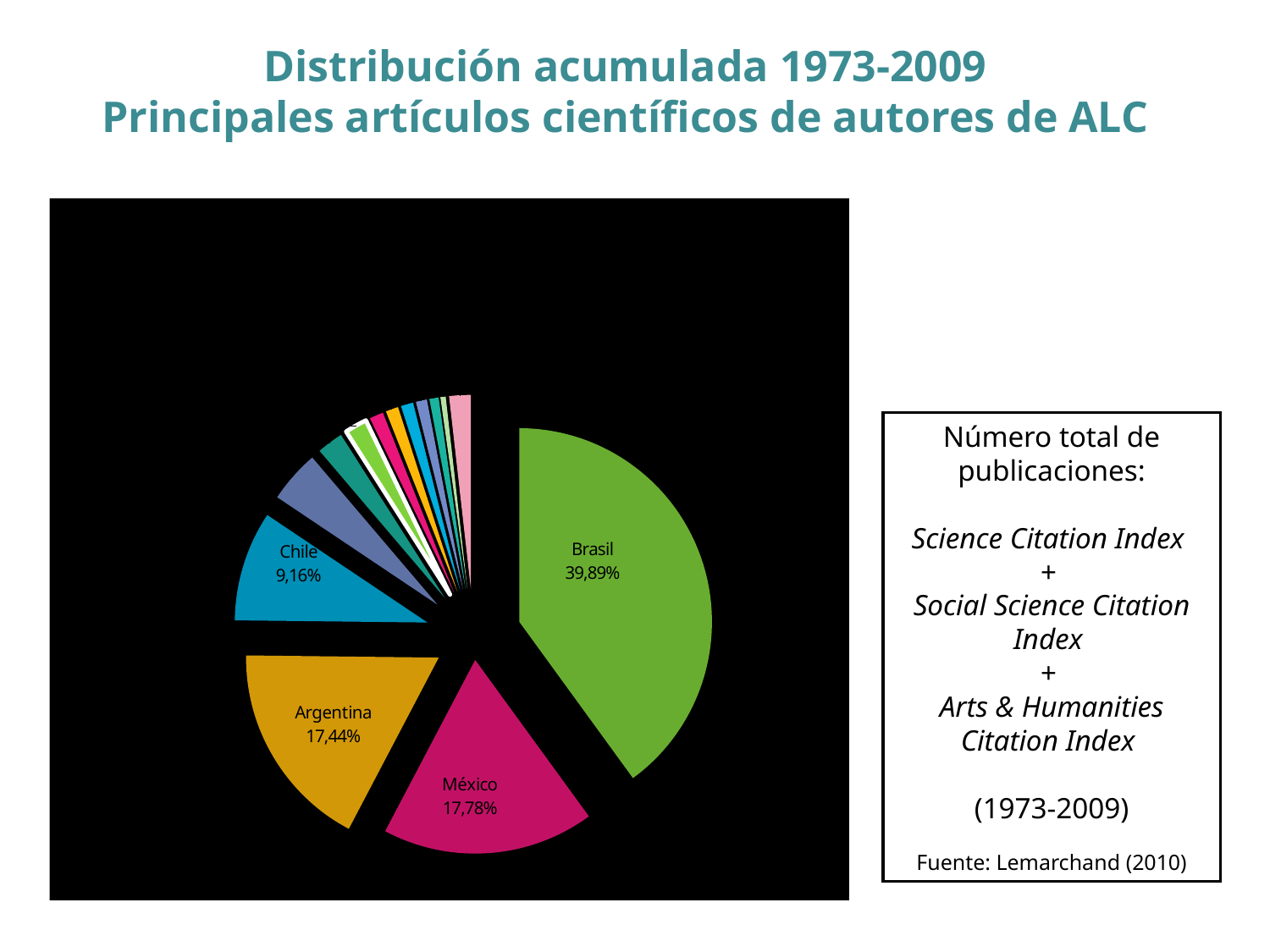
What is the difference between the shares of Argentina and Chile? 8,28% Which is larger, the share for México or the share for Argentina? México What is the value shown for Chile? 9,16% What kind of chart is shown on the slide? pie chart What is the combined share of Brasil, México, Argentina and Chile? 84,27% Which country has the largest slice of the pie? Brasil What share of the pie does Brasil hold? 39,89% What is the value shown for México? 17,78% Which is larger, the share for Argentina or the share for Chile? Argentina What is the difference between the shares of Brasil and México? 22,11% What source is cited for the chart data? Lemarchand (2010) What is the value shown for Argentina? 17,44%